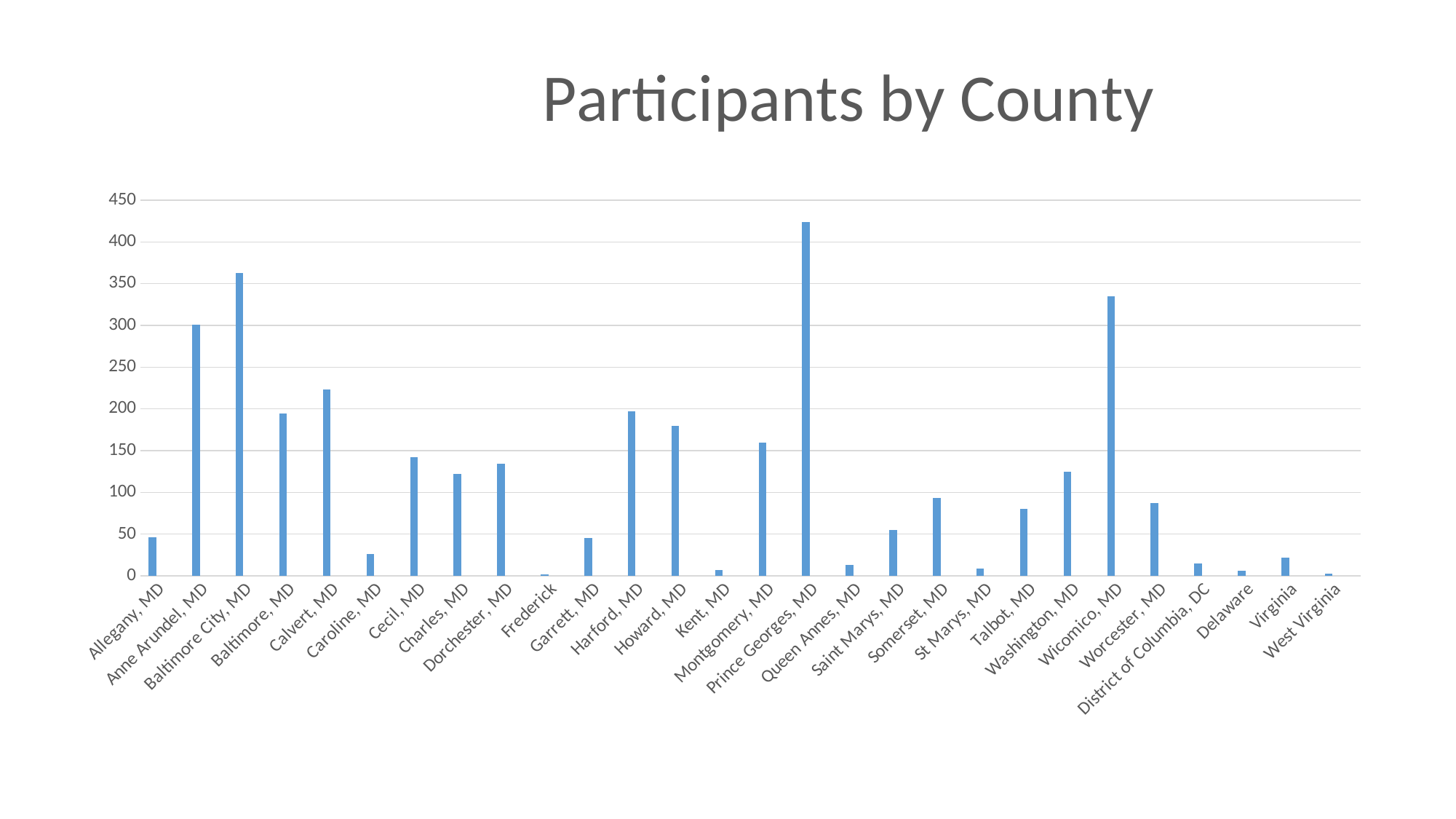
What type of chart is shown on the slide? bar chart Which has more participants, Howard, MD or Montgomery, MD? Howard, MD Is the value for Montgomery, MD greater or less than 150? greater Is the value for Talbot, MD greater or less than 100? less What is the title of the chart? Participants by County How many counties/categories are shown on the x axis? 28 Is the value for Baltimore City, MD greater or less than 350? greater Which county has the highest number of participants? Prince Georges, MD Which has more participants, Baltimore City, MD or Wicomico, MD? Baltimore City, MD